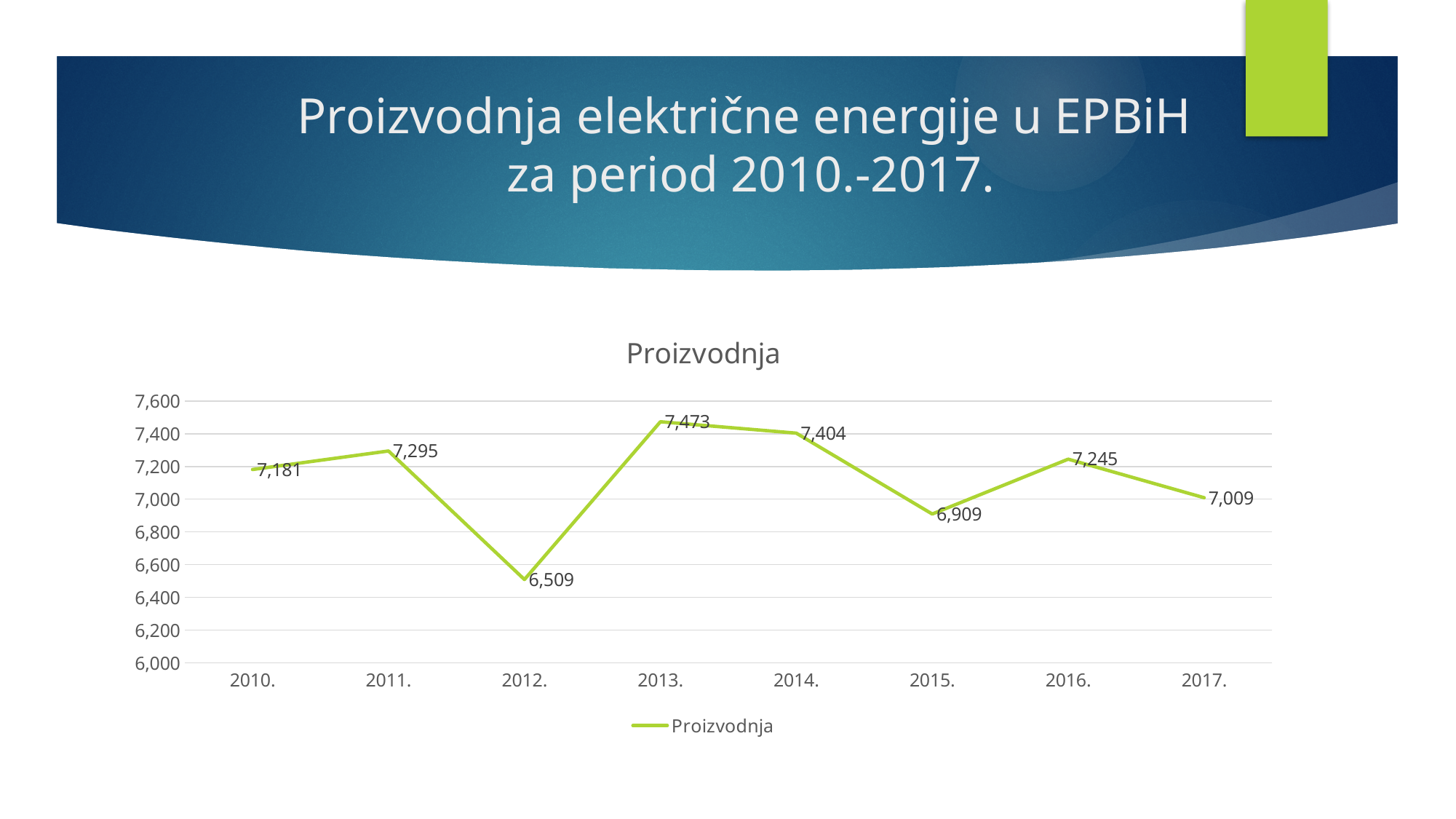
How many years are plotted in the Proizvodnja chart? 8 Which year has the highest value in the Proizvodnja chart? 2013. What is the value for 2010. in the Proizvodnja chart? 7,181 Which year has the lowest value in the Proizvodnja chart? 2012. Which is larger, the value for 2014. or the value for 2017.? 2014. What is the difference between the values for 2011. and 2010.? 114 Is the value for 2015. greater or less than 7,000? less What is the value for 2016. in the Proizvodnja chart? 7,245 What kind of chart is shown on the slide? line chart What is the value for 2012. in the Proizvodnja chart? 6,509 What is the difference between the values for 2013. and 2012.? 964 Does the value rise or fall from 2016. to 2017.? fall